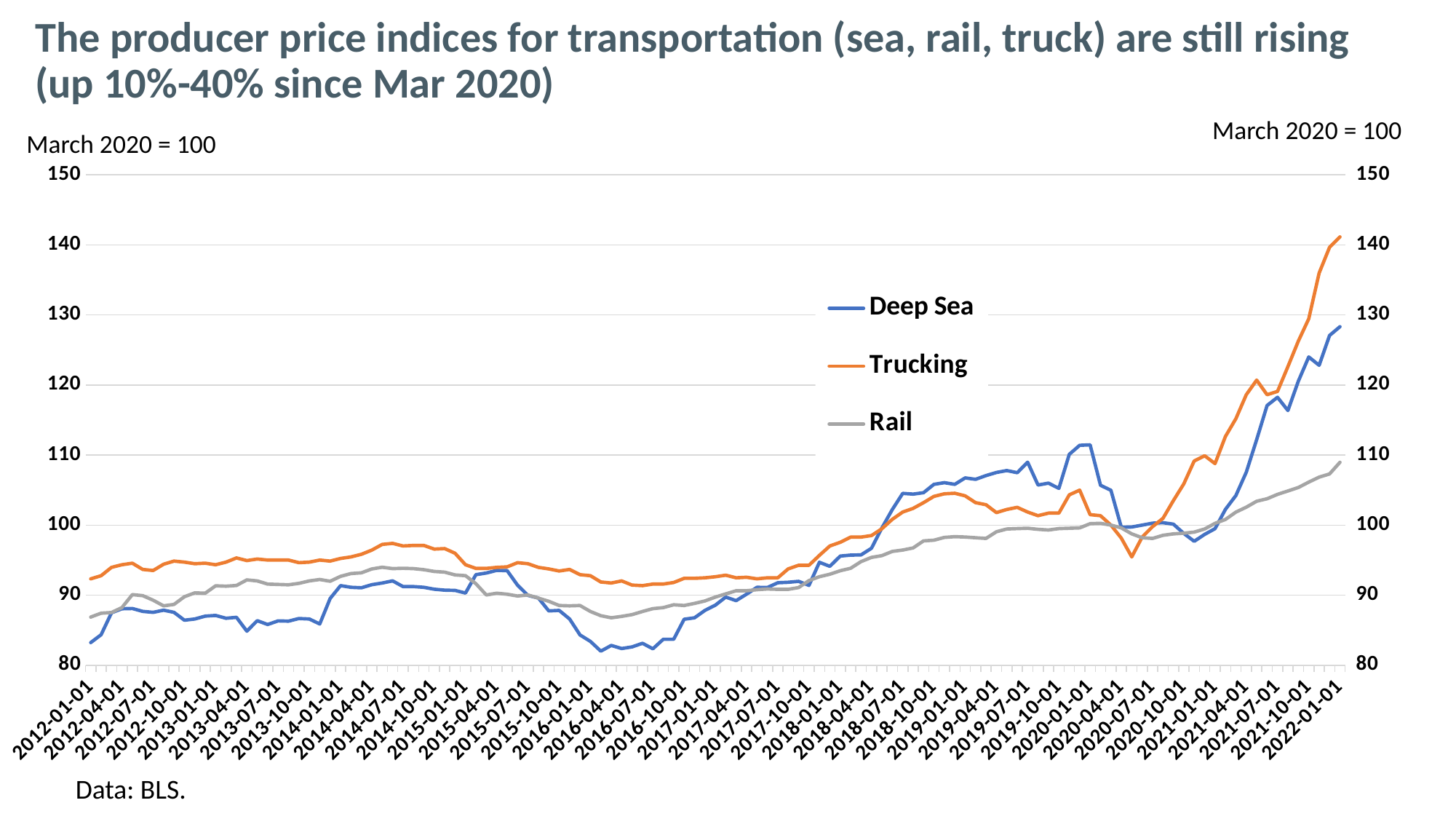
At 2012-01-01, which is higher, Trucking or Deep Sea? Trucking At 2022-01-01, which is higher, Rail or Deep Sea? Deep Sea Which series is lowest at the last point, 2022-01-01? Rail Is the value for Deep Sea at 2012-01-01 greater or less than 90? less How many series does the legend list? 3 Is the value for Trucking at 2022-01-01 greater or less than 130? greater What kind of chart is shown on the slide? Line chart Which series is highest at the last point, 2022-01-01? Trucking Does the Rail series rise or fall between 2020-07-01 and 2022-01-01? Rise Is the value for Deep Sea at 2022-01-01 greater or less than 120? greater What base period is the index set to 100, according to the axis note? March 2020 = 100